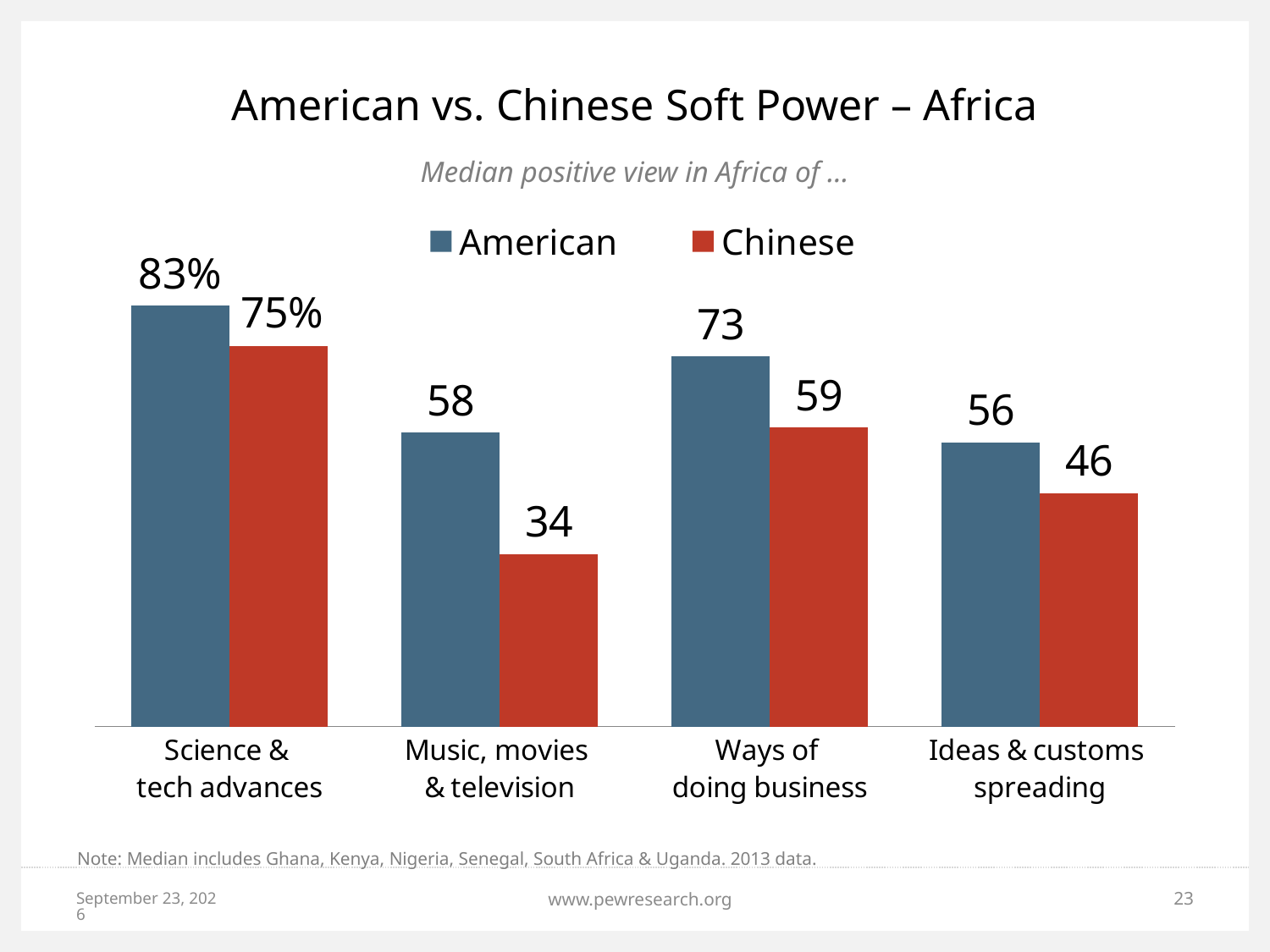
What is the difference between the American and Chinese values for Ways of doing business? 14 What kind of chart is shown on the slide? Bar chart How many categories are shown on the x axis? 4 What is the Chinese value for Ways of doing business? 59 Which category has the lowest Chinese value? Music, movies & television Which is larger for Ideas & customs spreading, the American or the Chinese value? American What is the American value for Science & tech advances? 83% What is the Chinese value for Music, movies & television? 34 How many series does the legend list? 2 What is the difference between the American and Chinese values for Music, movies & television? 24 Which category has the highest American value? Science & tech advances What is the American value for Ideas & customs spreading? 56